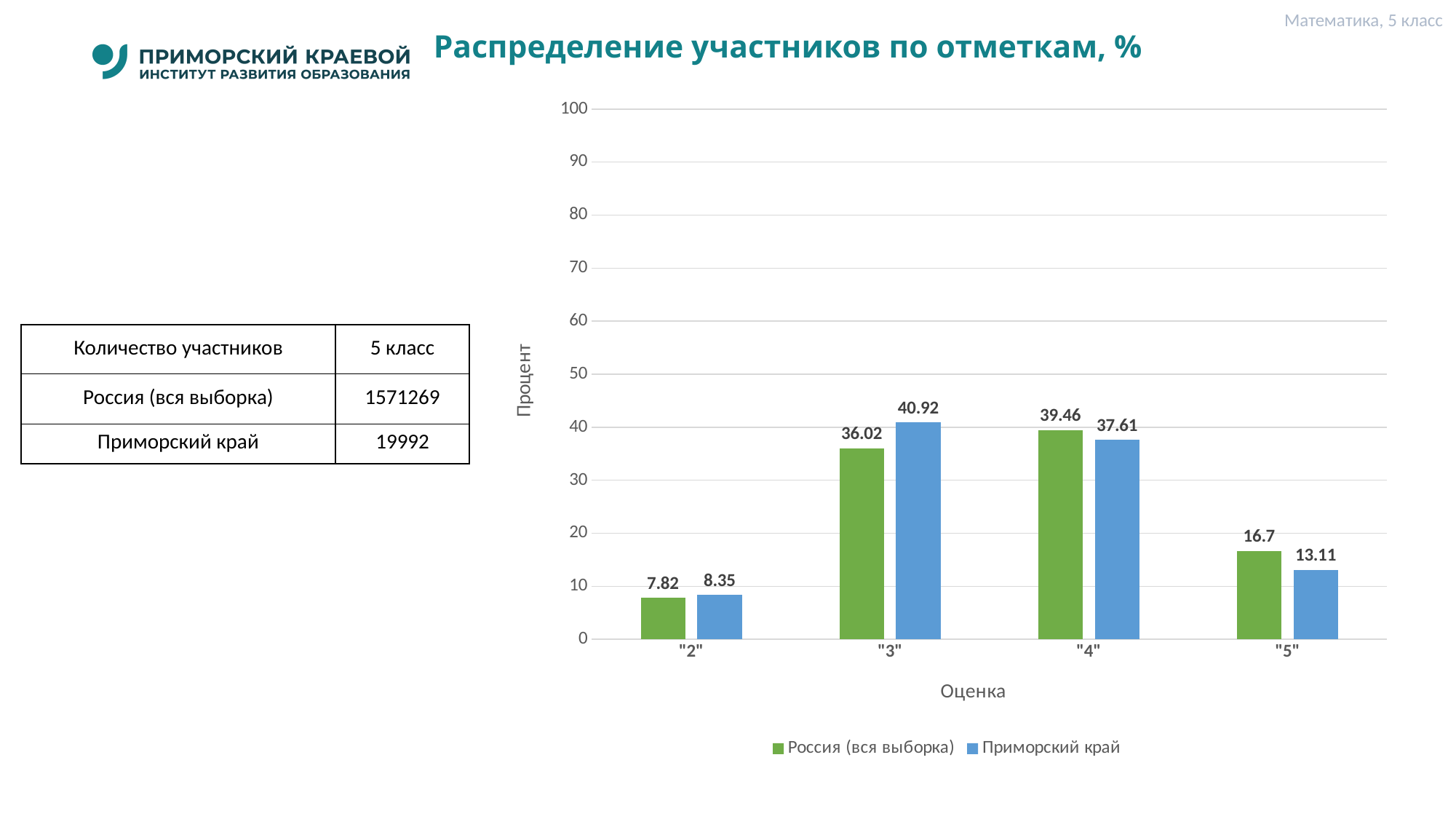
Is the value for Россия (вся выборка) at grade "5" greater or less than 20? less How many grade categories are shown on the x axis? 4 Which grade has the highest value for Приморский край? "3" At grade "4", which series has the larger value: Россия (вся выборка) or Приморский край? Россия (вся выборка) Which grade has the lowest value for Россия (вся выборка)? "2" What is the value for Россия (вся выборка) at grade "3"? 36.02 How many series does the legend list? 2 What kind of chart is shown on the slide? bar chart What is the value for Приморский край at grade "5"? 13.11 What is the title of the chart? Распределение участников по отметкам, % What is the difference between Приморский край and Россия (вся выборка) at grade "3"? 4.9 What is the value for Приморский край at grade "2"? 8.35